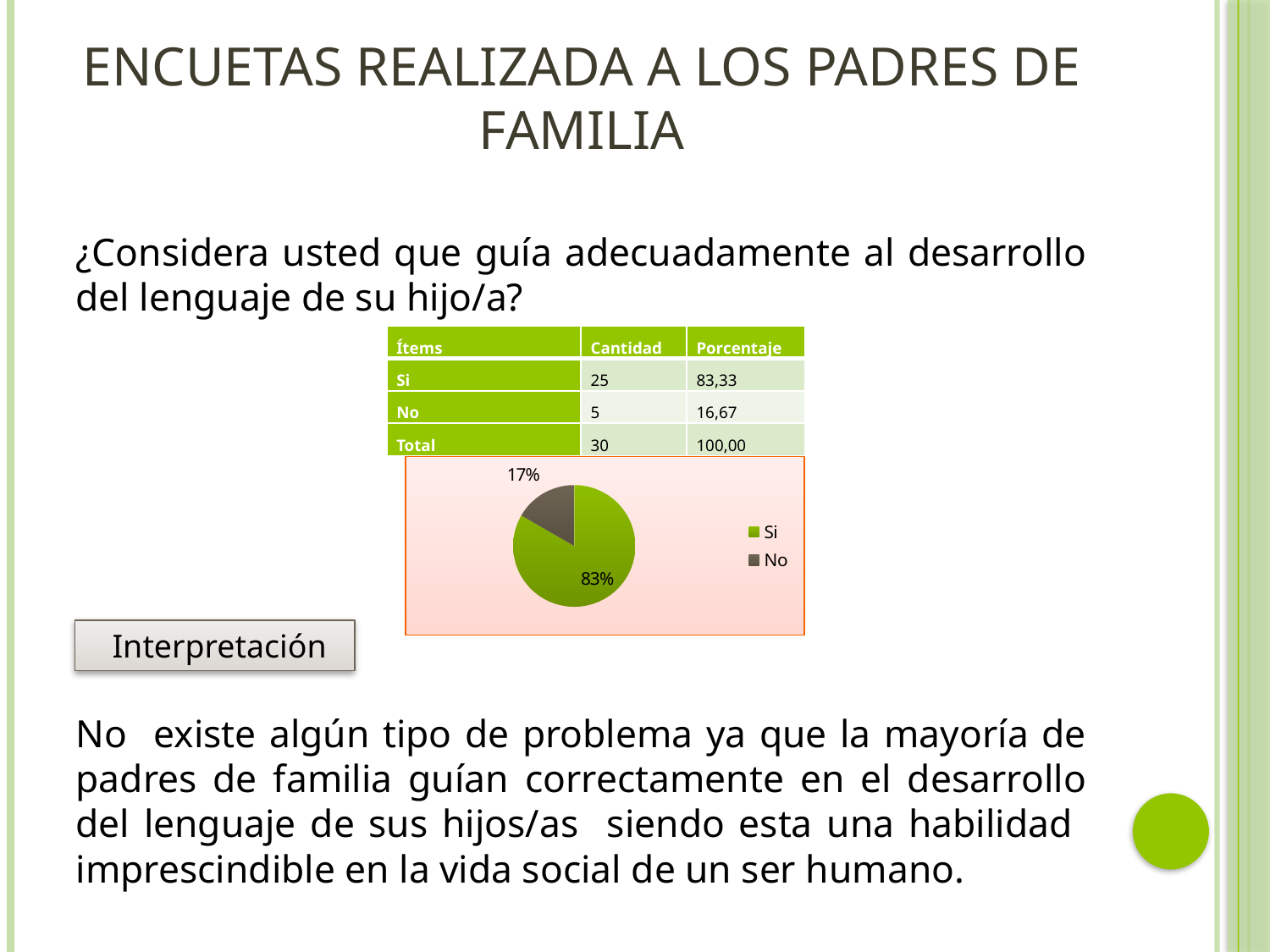
What percentage does the pie chart show for Si? 83% How many entries does the pie chart's legend list? 2 What share of the pie does the No slice represent? 17% Which slice of the pie chart is the largest? Si What is the difference in percentage points between the Si and No slices in the pie chart? 66 What kind of chart is shown on the slide? pie chart What colour is the Si slice in the pie chart? green Which slice of the pie chart is the smallest? No How many slices does the pie chart have? 2 Which is larger in the pie chart, Si or No? Si What percentage does the pie chart show for No? 17% Is the share for Si in the pie chart greater or less than 50%? greater